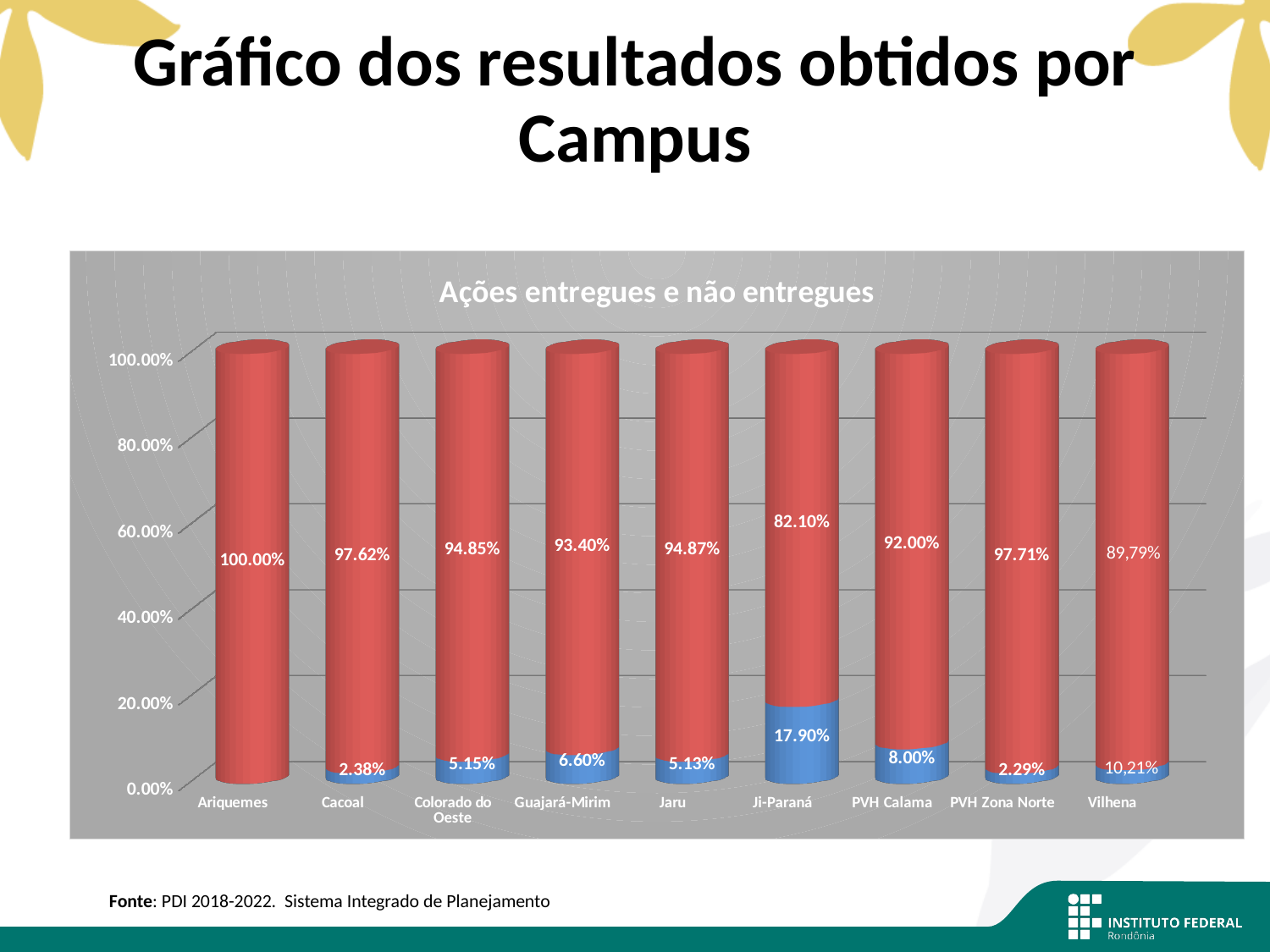
What is the value of the blue segment for PVH Calama? 8.00% Which is larger, the blue segment for Colorado do Oeste or the blue segment for Jaru? Colorado do Oeste What is the value of the red segment for Cacoal? 97.62% Which campus has the smallest red segment? Ji-Paraná What is the value of the blue segment for Vilhena? 10,21% How many campuses are shown on the x axis? 9 Which campus has the largest blue segment? Ji-Paraná What is the difference between the blue segment values for Ji-Paraná and Guajará-Mirim? 11.30% Is the red segment value for Ji-Paraná greater or less than 80.00%? greater What is the value of the red segment for Ji-Paraná? 82.10% What is the title of the chart? Ações entregues e não entregues What kind of chart is shown on the slide? Stacked bar chart